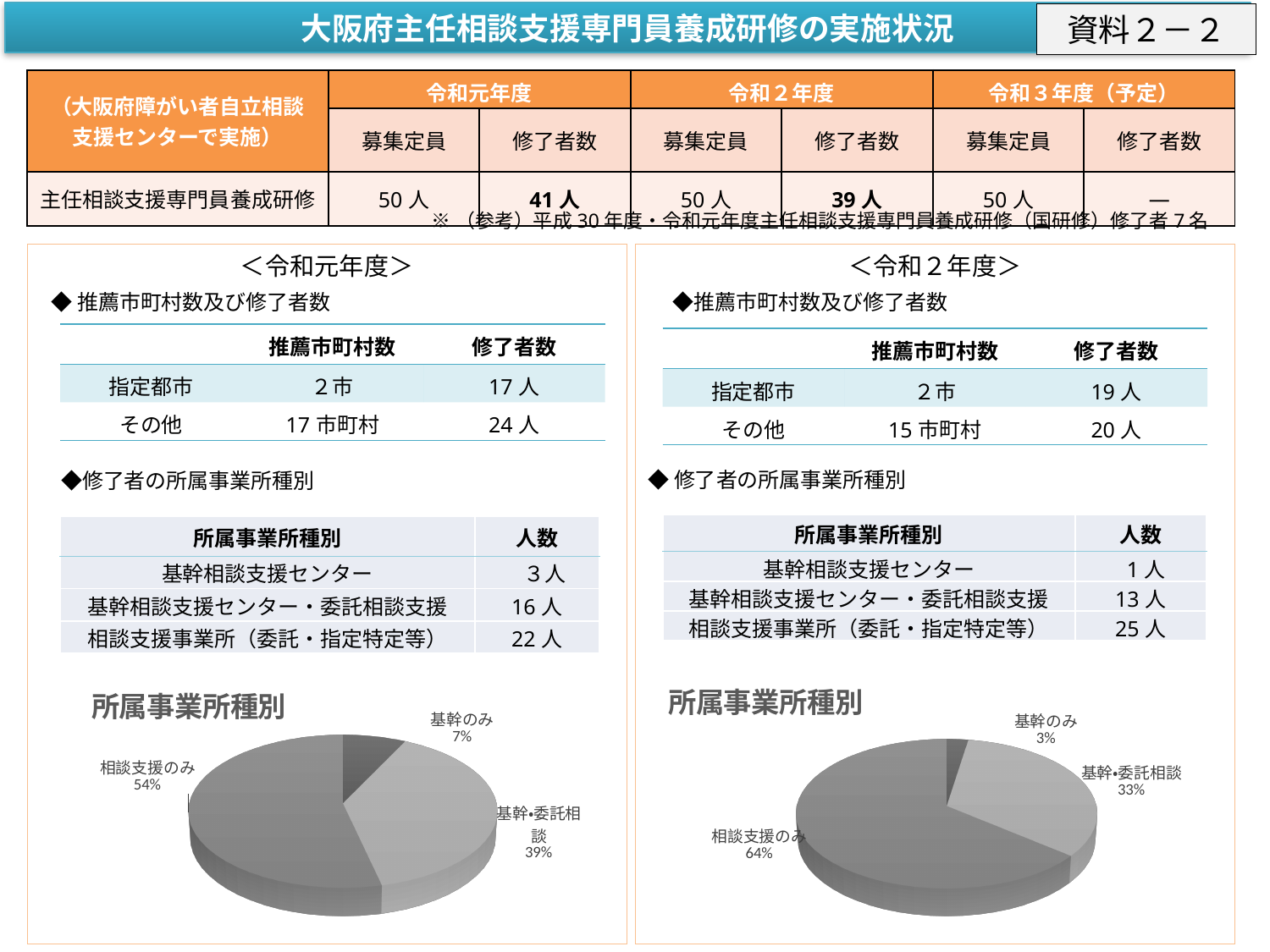
In the right pie chart (令和2年度 所属事業所種別), what share does 基幹のみ have? 3% In the left pie chart (令和元年度 所属事業所種別), what share does 基幹のみ have? 7% In the right pie chart (令和2年度 所属事業所種別), what share does 相談支援のみ have? 64% In the right pie chart (令和2年度), which is larger, 基幹・委託相談 or 基幹のみ? 基幹・委託相談 In the left pie chart (令和元年度), which category has the largest slice? 相談支援のみ In the right pie chart (令和2年度), which category has the smallest slice? 基幹のみ In the left pie chart (令和元年度), what is the difference in percentage points between 相談支援のみ and 基幹・委託相談? 15 How many slices does the left pie chart (令和元年度) have? 3 What type of chart is used for 所属事業所種別 on the right side of the slide? Pie chart